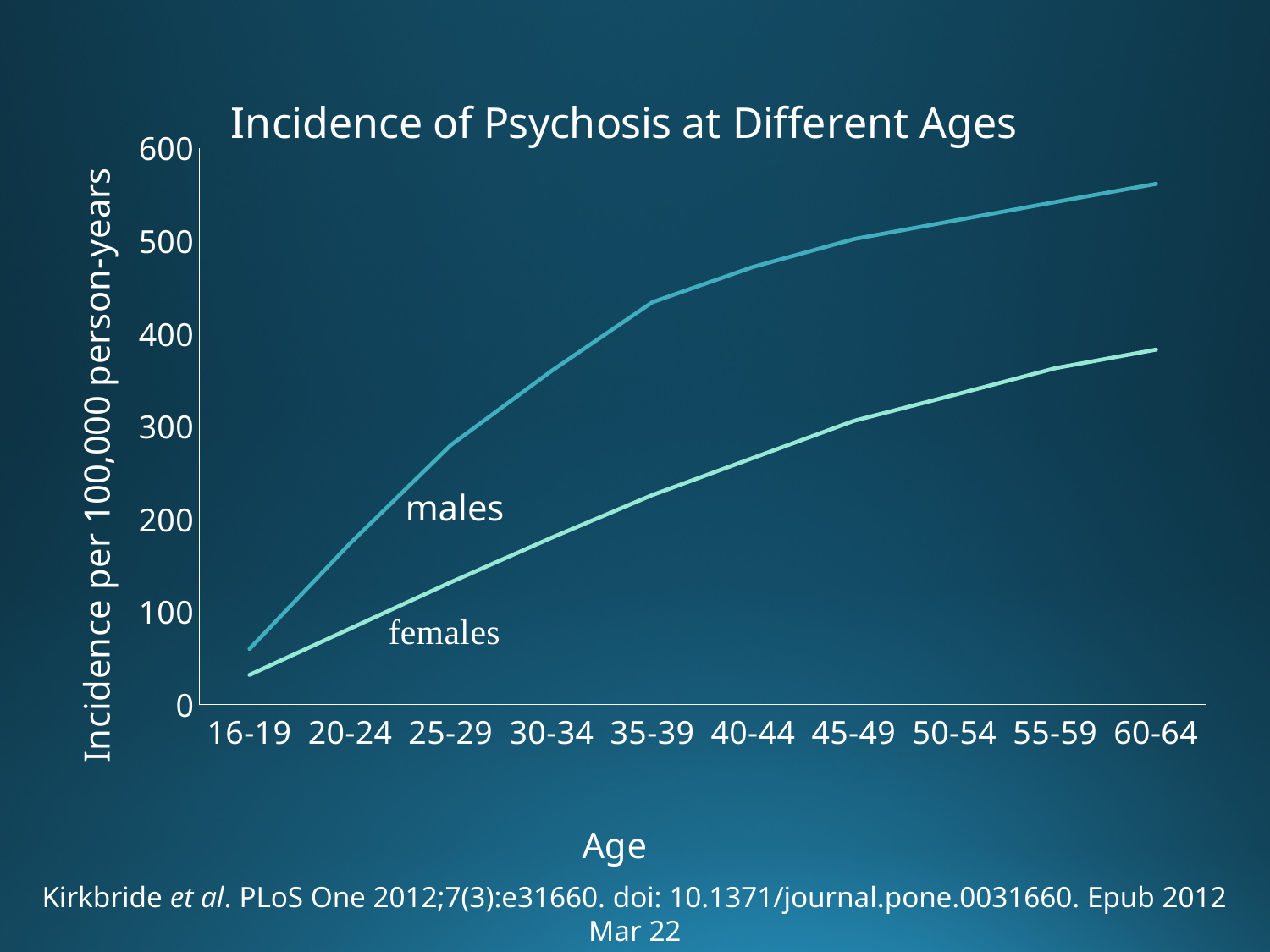
Is the value for males at age 60-64 greater or less than 500? greater How many age groups are shown on the x axis? 10 Do the values for males rise or fall as age increases along the x axis? rise For which age group is the incidence for females lowest? 16-19 What is the label of the y axis? Incidence per 100,000 person-years How many series are plotted on the chart? 2 What is the title of the chart? Incidence of Psychosis at Different Ages Is the value for males at age 16-19 greater or less than 100? less For which age group is the incidence for males highest? 60-64 What kind of chart is shown on the slide? line chart Is the value for females at age 60-64 greater or less than 400? less Which series has the higher value at age 40-44, males or females? males